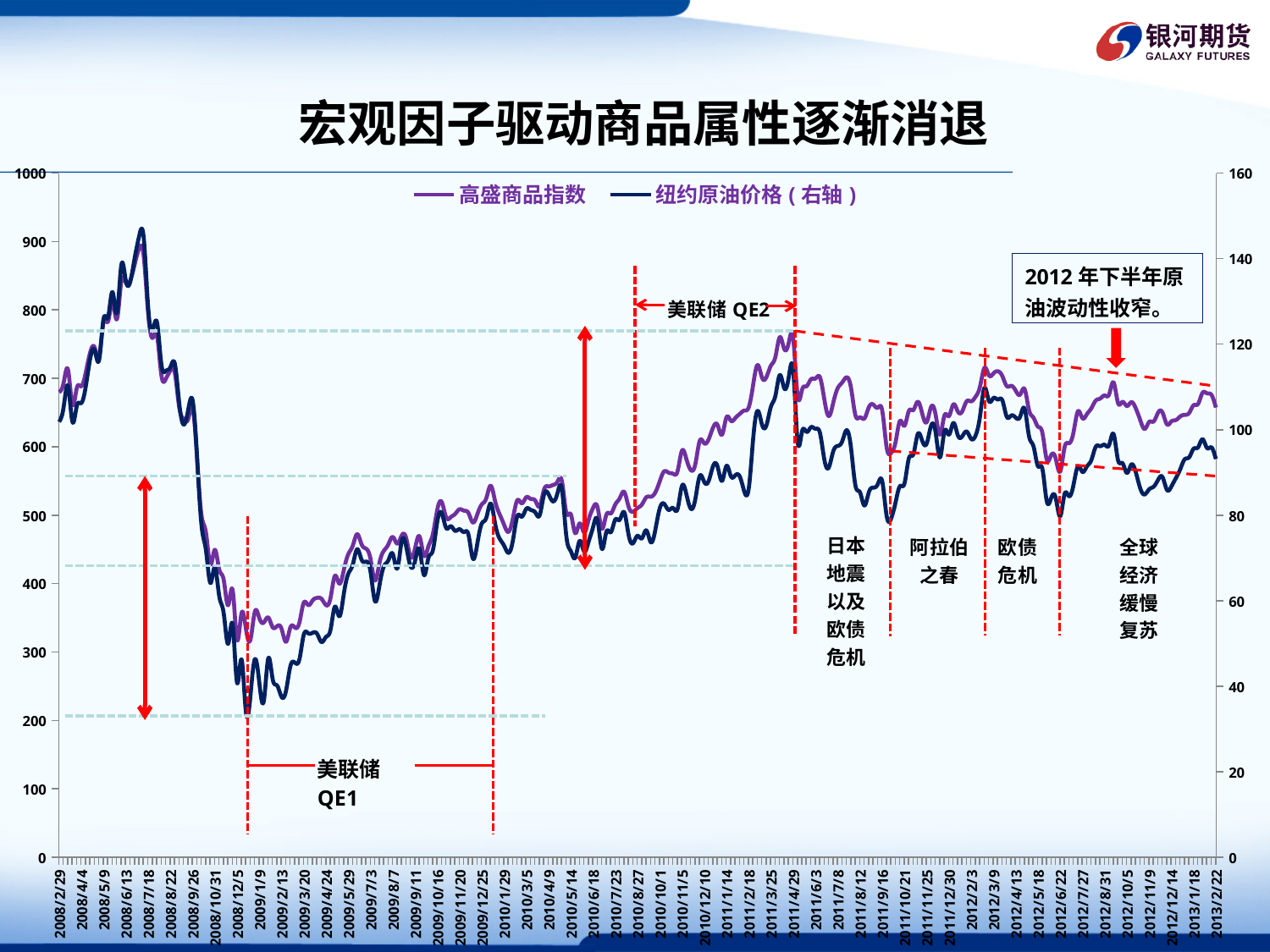
Is the lowest value of 纽约原油价格 in early 2009 greater or less than 40 on the right axis? less Does 纽约原油价格 rise or fall between 2009/2/13 and 2011/4/29? rise How many series does the legend list? 2 Is the peak value of 纽约原油价格 in mid-2008 greater or less than 120 on the right axis? greater Does 高盛商品指数 rise or fall between 2008/7/18 and 2008/12/5? fall Is the lowest value of 高盛商品指数 in early 2009 greater or less than 400? less What is the title of the slide's chart? 宏观因子驱动商品属性逐渐消退 What kind of chart is shown on the slide? line chart Which series is plotted against the right axis according to the legend? 纽约原油价格（右轴）